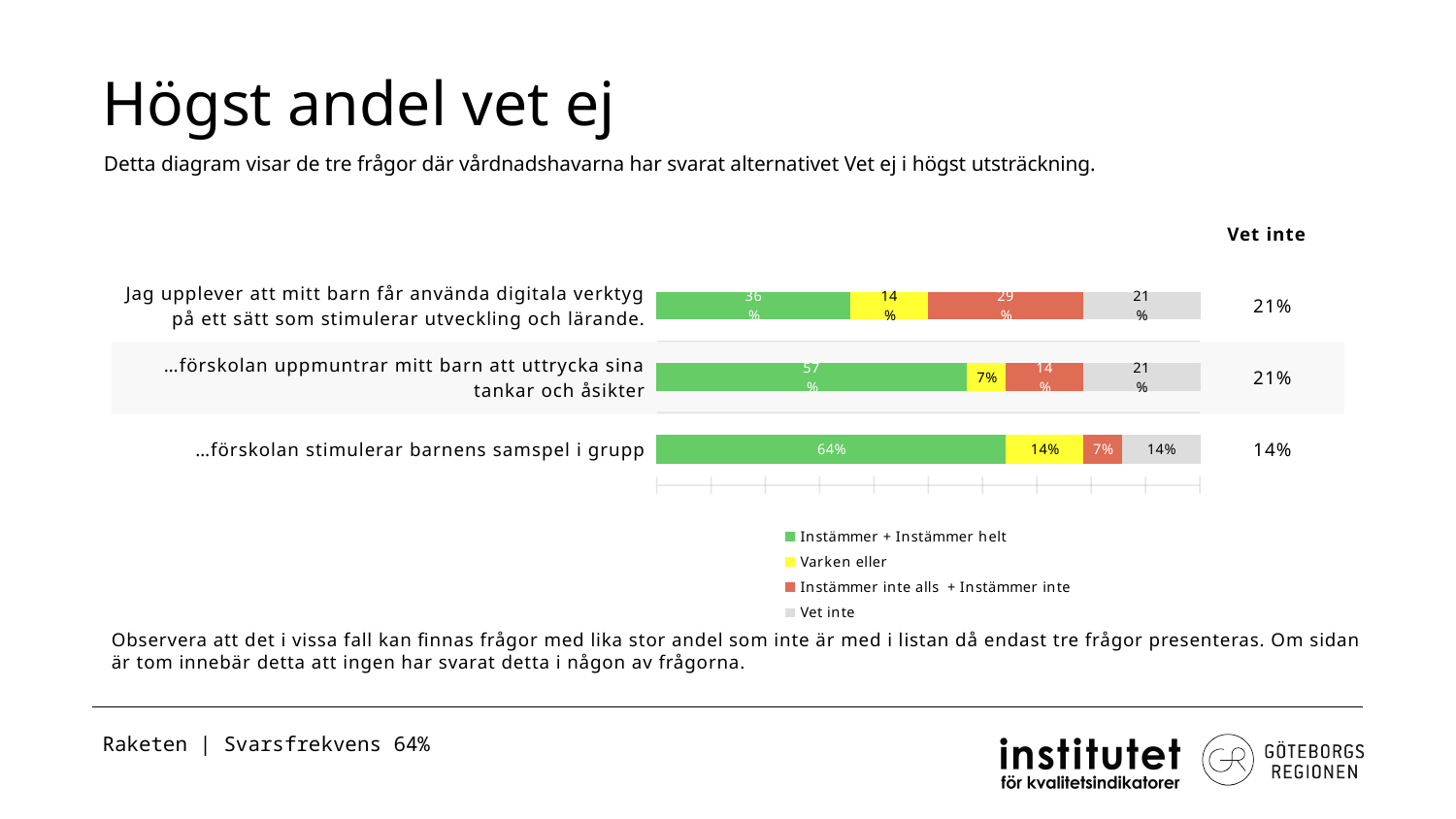
What kind of chart is shown on the slide? stacked bar chart Which category has the lowest 'Instämmer + Instämmer helt' value? Jag upplever att mitt barn får använda digitala verktyg på ett sätt som stimulerar utveckling och lärande. What is the difference between the 'Instämmer + Instämmer helt' values for '…förskolan stimulerar barnens samspel i grupp' and '…förskolan uppmuntrar mitt barn att uttrycka sina tankar och åsikter'? 7% What is the title of the slide containing the chart? Högst andel vet ej How many series does the legend list? 4 How many categories (questions) are plotted in the chart? 3 Which category has the highest 'Instämmer + Instämmer helt' value? …förskolan stimulerar barnens samspel i grupp What is the 'Vet inte' value for '…förskolan stimulerar barnens samspel i grupp'? 14% What is the 'Varken eller' value for '…förskolan uppmuntrar mitt barn att uttrycka sina tankar och åsikter'? 7% What is the 'Instämmer inte alls + Instämmer inte' value for 'Jag upplever att mitt barn får använda digitala verktyg på ett sätt som stimulerar utveckling och lärande.'? 29% Which is larger: the 'Instämmer inte alls + Instämmer inte' value for 'Jag upplever att mitt barn får använda digitala verktyg…' or for '…förskolan uppmuntrar mitt barn att uttrycka sina tankar och åsikter'? Jag upplever att mitt barn får använda digitala verktyg på ett sätt som stimulerar utveckling och lärande. What is the 'Instämmer + Instämmer helt' value for '…förskolan stimulerar barnens samspel i grupp'? 64%